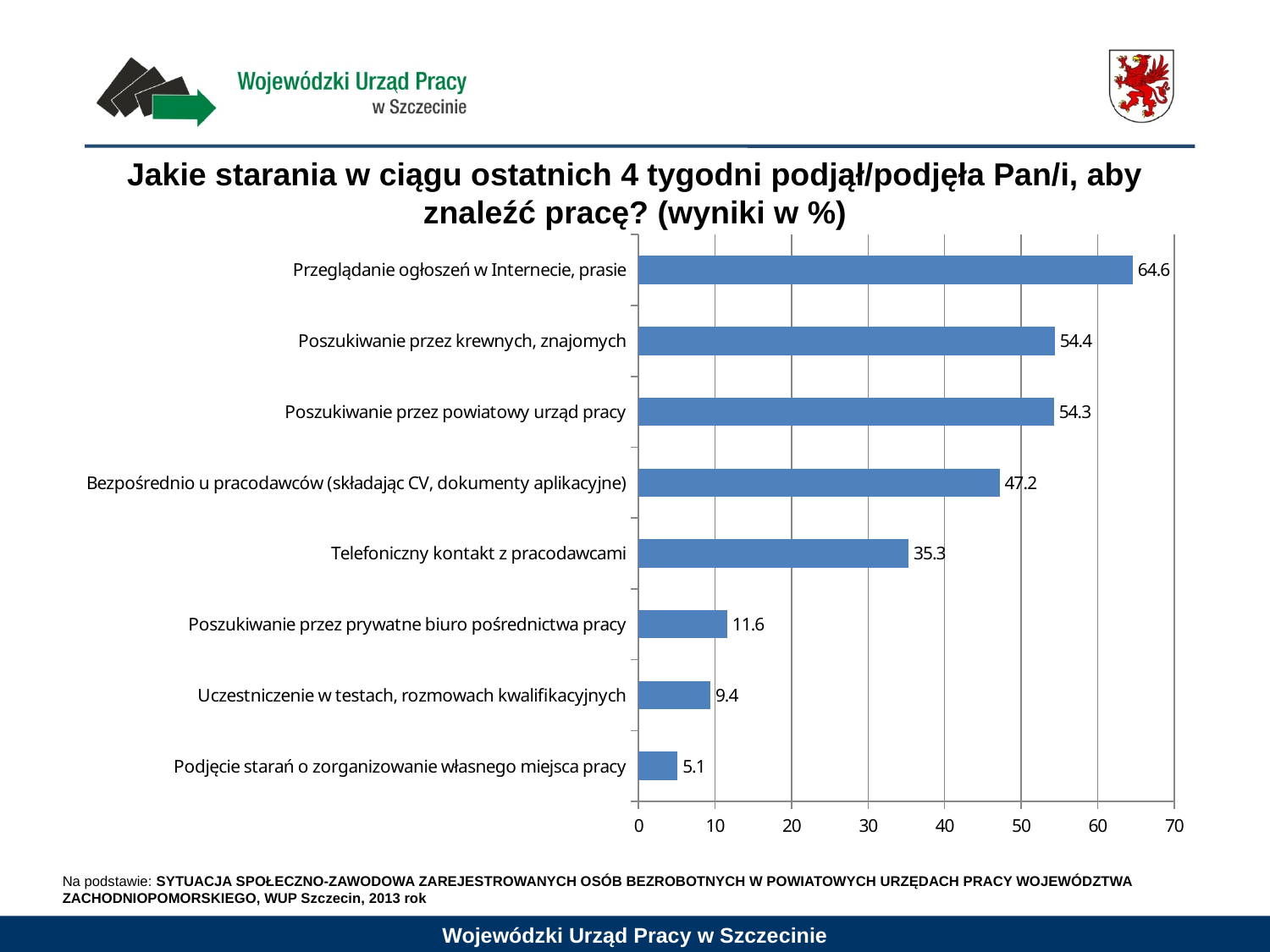
What kind of chart is shown on the slide? bar chart What is the value for "Telefoniczny kontakt z pracodawcami"? 35.3 Which category has the lowest value? Podjęcie starań o zorganizowanie własnego miejsca pracy What is the difference between the values for "Poszukiwanie przez prywatne biuro pośrednictwa pracy" and "Uczestniczenie w testach, rozmowach kwalifikacyjnych"? 2.2 What is the maximum value shown on the horizontal axis? 70 What is the value for "Podjęcie starań o zorganizowanie własnego miejsca pracy"? 5.1 Which category has the highest value? Przeglądanie ogłoszeń w Internecie, prasie What is the difference between the values for "Przeglądanie ogłoszeń w Internecie, prasie" and "Bezpośrednio u pracodawców (składając CV, dokumenty aplikacyjne)"? 17.4 What is the value for "Przeglądanie ogłoszeń w Internecie, prasie"? 64.6 Is the value for "Poszukiwanie przez krewnych, znajomych" greater or less than 50? greater How many categories are shown in the chart? 8 Which is larger: the value for "Telefoniczny kontakt z pracodawcami" or the value for "Bezpośrednio u pracodawców (składając CV, dokumenty aplikacyjne)"? Bezpośrednio u pracodawców (składając CV, dokumenty aplikacyjne)